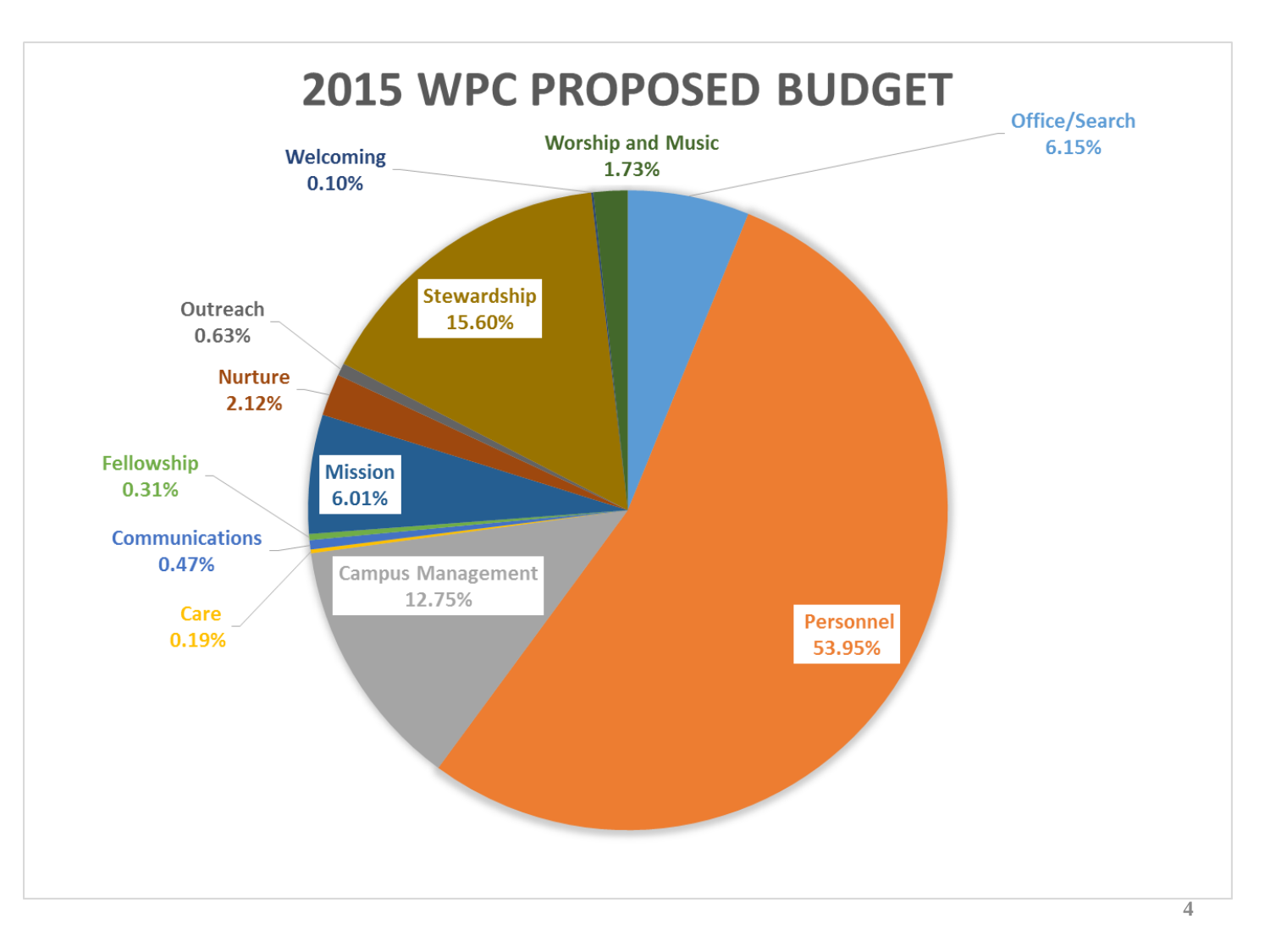
What percentage of the budget is allocated to Campus Management? 12.75% Which category has the largest share of the budget? Personnel What type of chart is shown on the slide? Pie chart Which has a larger share of the budget, Office/Search or Mission? Office/Search What percentage of the budget is allocated to Welcoming? 0.10% What is the difference between the Stewardship and Campus Management shares? 2.85% What percentage of the budget is allocated to Stewardship? 15.60% What is the combined share of Nurture and Outreach? 2.75% How many categories are shown in the pie chart? 12 What is the title of the chart? 2015 WPC PROPOSED BUDGET Which category has the smallest share of the budget? Welcoming What percentage of the budget is allocated to Personnel? 53.95%